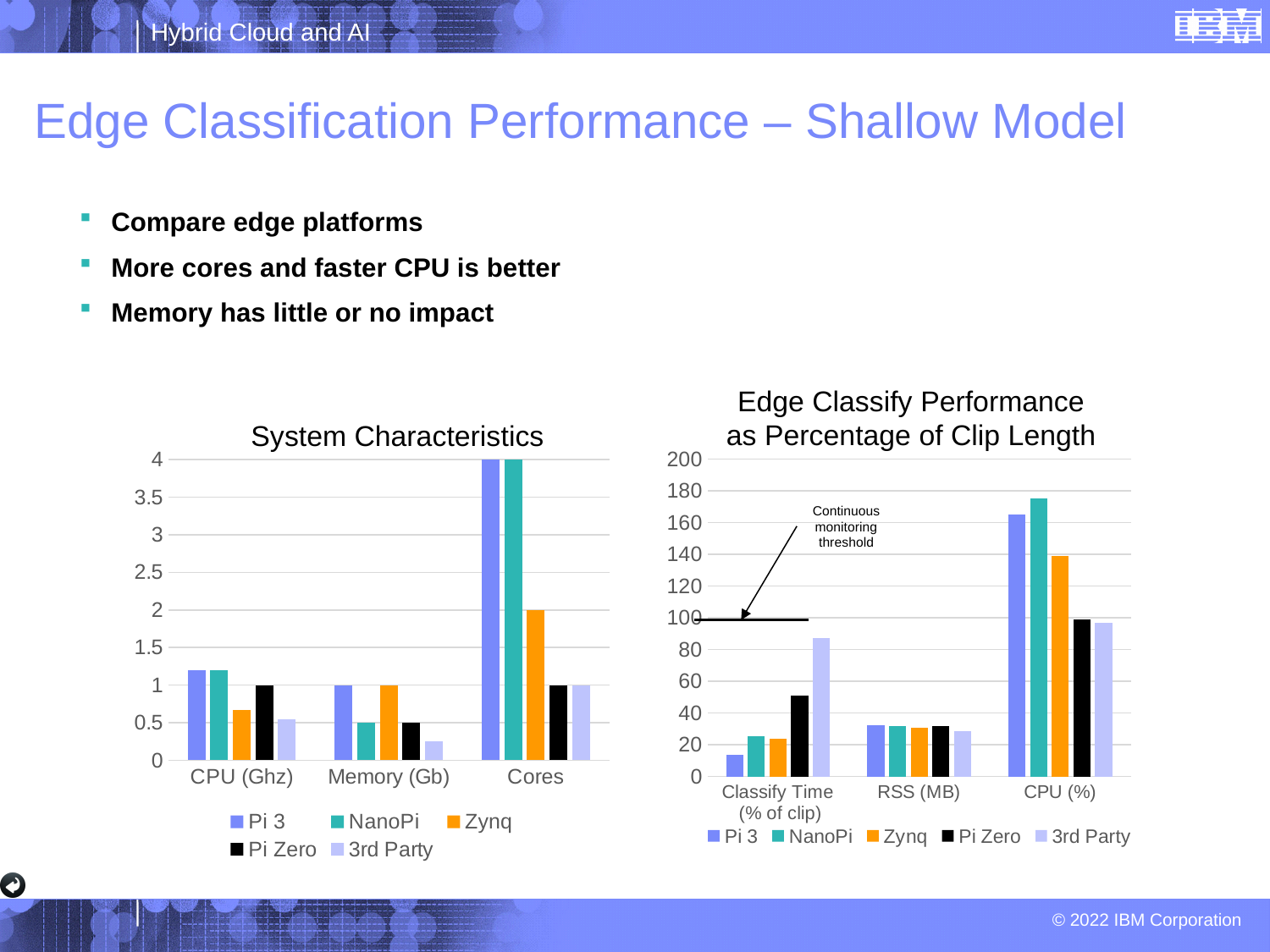
In the Edge Classify Performance as Percentage of Clip Length chart, is the CPU (%) value for Zynq greater or less than 120? greater In the System Characteristics chart, what is the Cores value for Pi Zero? 1 In the System Characteristics chart, what is the Cores value for Zynq? 2 In the System Characteristics chart, is the Cores value for Pi 3 larger or smaller than the Cores value for Zynq? larger How many series does the legend of the System Characteristics chart list? 5 In the Edge Classify Performance as Percentage of Clip Length chart, which series has the highest CPU (%) value? NanoPi In the Edge Classify Performance as Percentage of Clip Length chart, what does the annotation at the 100 line say? Continuous monitoring threshold In the System Characteristics chart, which series has the lowest Memory (Gb) value? 3rd Party In the Edge Classify Performance as Percentage of Clip Length chart, is the Classify Time (% of clip) value for 3rd Party greater or less than 80? greater How many categories are shown on the x axis of the Edge Classify Performance as Percentage of Clip Length chart? 3 What kind of chart is the System Characteristics chart? bar chart In the System Characteristics chart, what is the Memory (Gb) value for Pi 3? 1